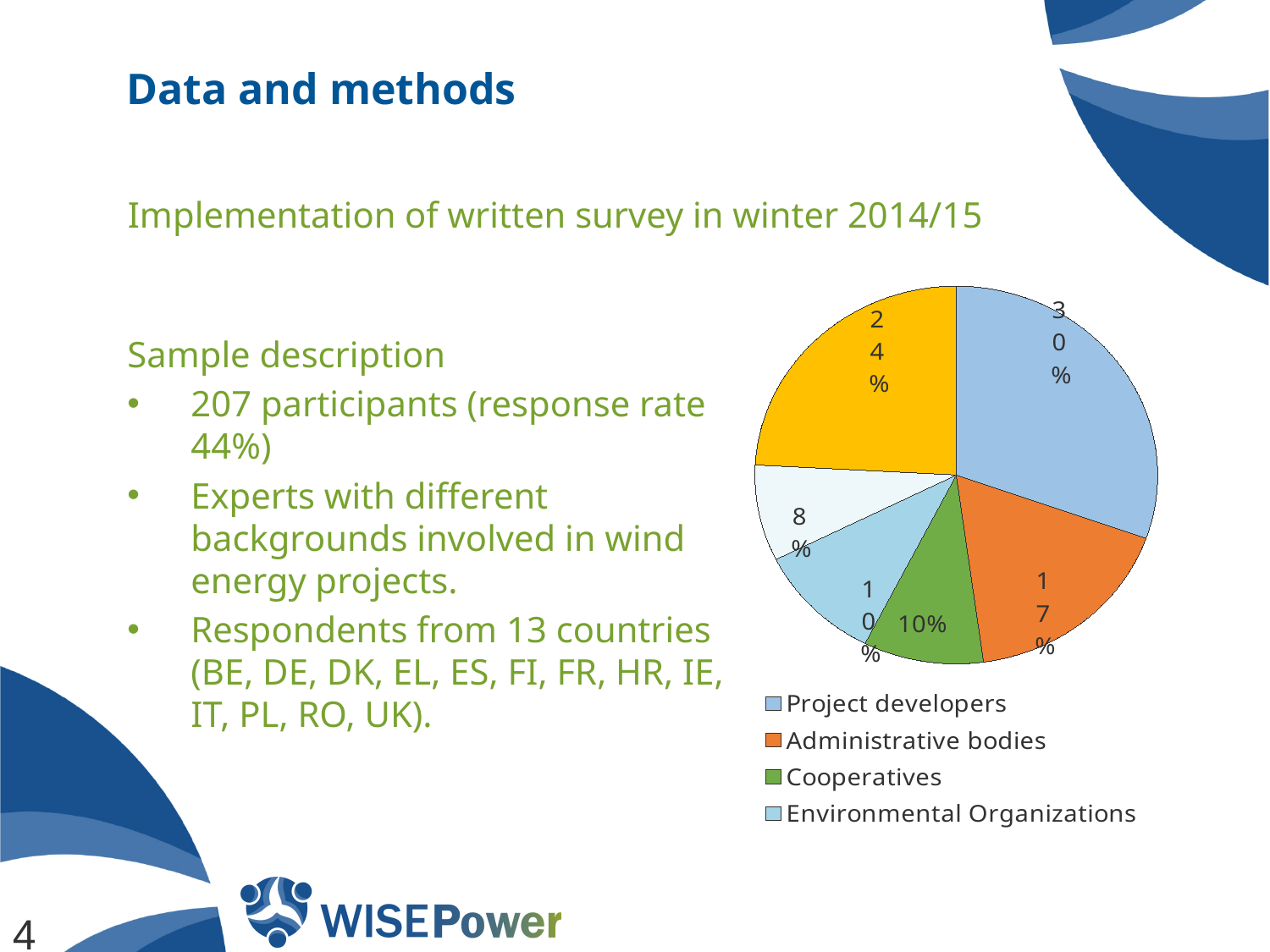
What is the value printed on the smallest slice of the pie chart? 8% Which slice is larger in the pie chart, Project developers or Administrative bodies? Project developers How many entries does the pie chart's legend list? 4 How many slices does the pie chart have? 6 What share of the pie chart is labelled for Administrative bodies? 17% What is the value printed on the largest slice of the pie chart? 30% By how many percentage points does the Project developers slice exceed the Administrative bodies slice? 13 What share of the pie chart is labelled for Project developers? 30% What share of the pie chart is labelled for Environmental Organizations? 10% What share of the pie chart is labelled for Cooperatives? 10% Which legend category has the largest slice in the pie chart? Project developers What kind of chart is shown on the slide? pie chart